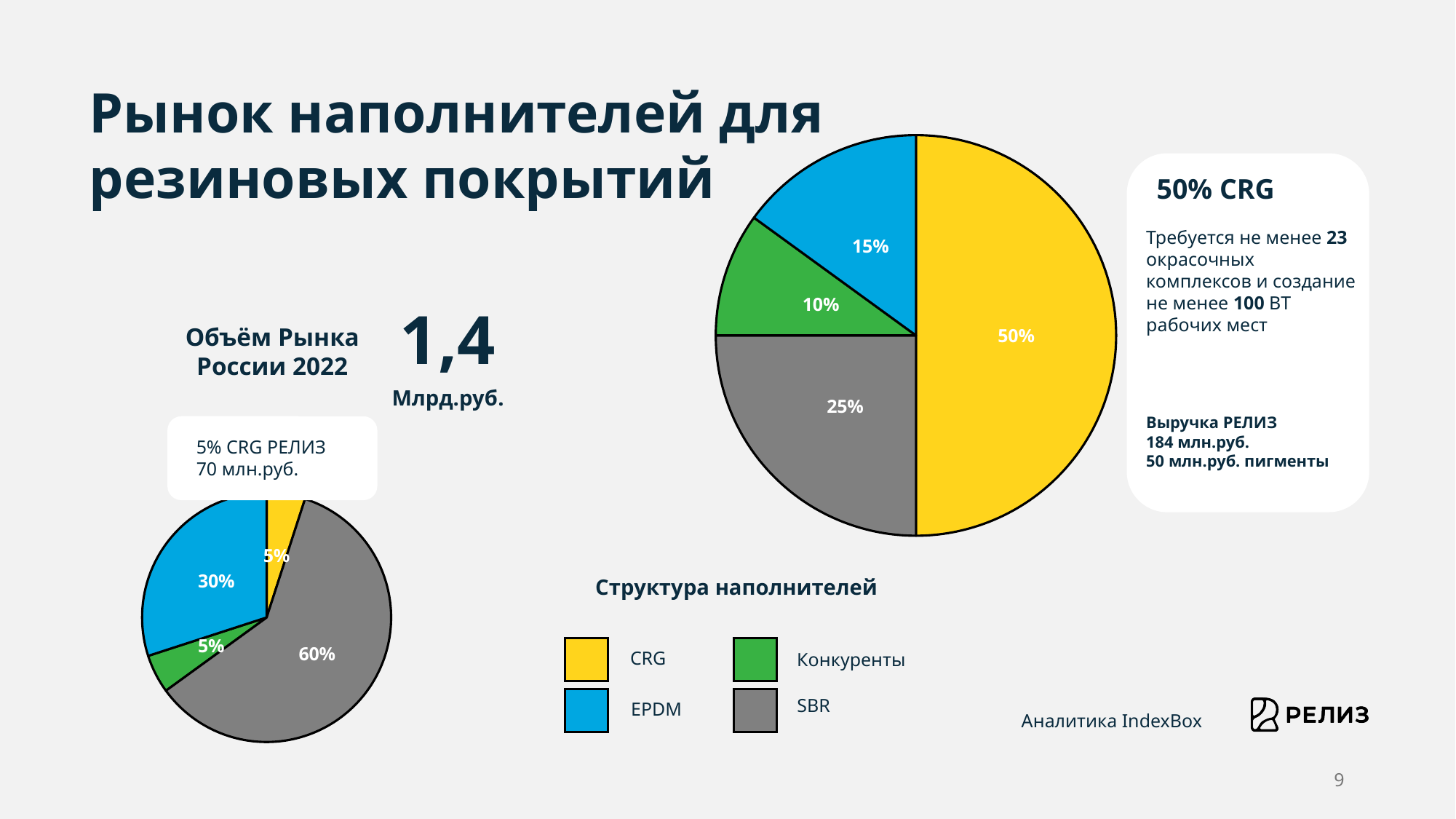
In the larger pie chart on the right, what share does CRG (yellow) have? 50% What colour represents CRG in the pie charts? yellow In the smaller pie chart on the left, what share does SBR (grey) have? 60% What type of chart is used on this slide? pie chart In the smaller pie chart on the left, which category has the largest share? SBR In the larger pie chart on the right, which category has the smallest share? Конкуренты In the larger pie chart on the right, what share does SBR (grey) have? 25% In the larger pie chart on the right, what share does EPDM (blue) have? 15% How many categories does the legend list? 4 In the larger pie chart on the right, which is larger: the share of SBR or the share of EPDM? SBR In the smaller pie chart on the left, what is the difference between the SBR share and the EPDM share? 30% In the smaller pie chart on the left, what share does EPDM (blue) have? 30%